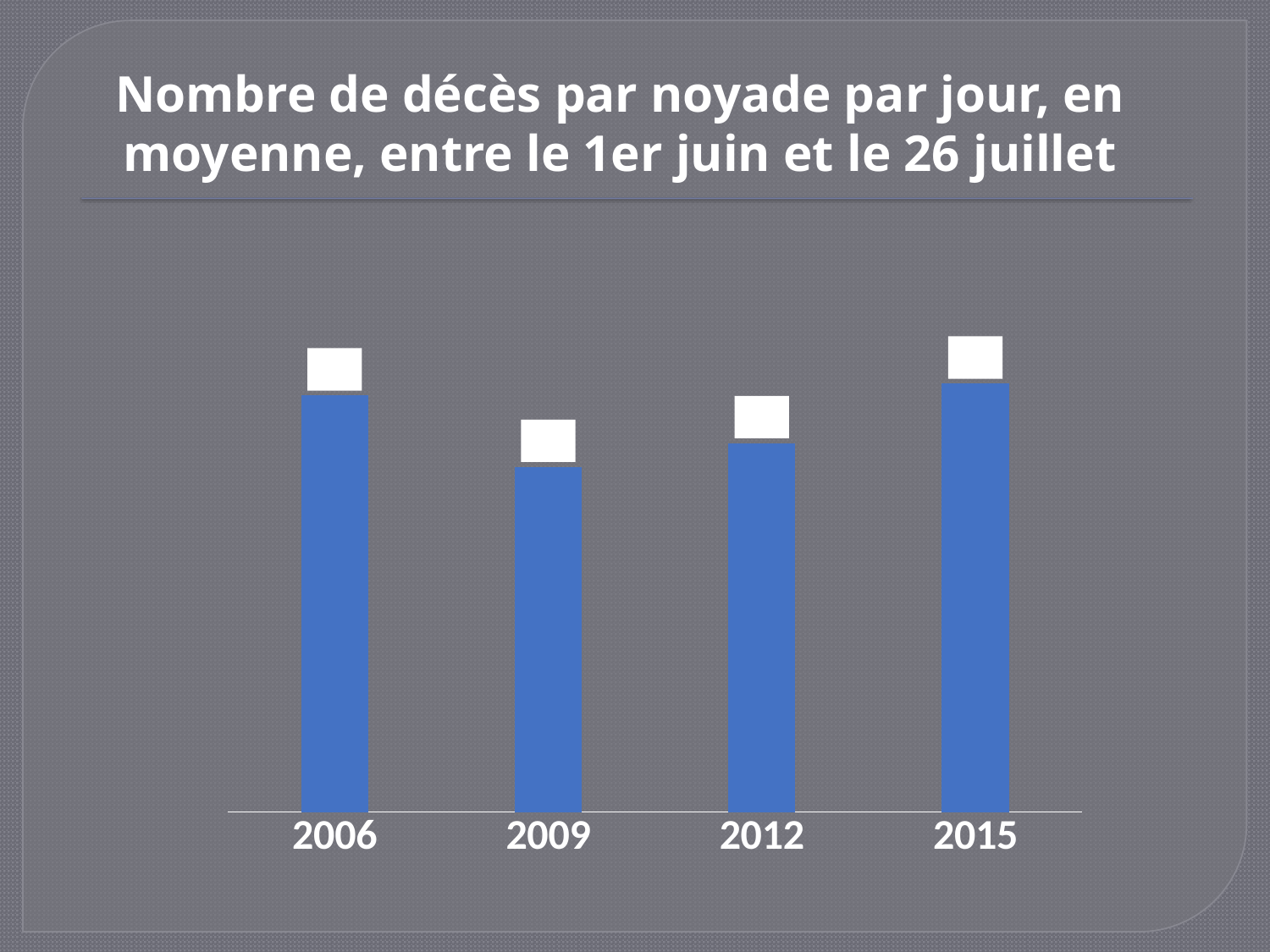
How many years are shown on the x axis of the chart? 4 Does the value rise or fall from 2006 to 2009? fall Which year is shown first on the x axis of the chart? 2006 Which year has the higher bar, 2006 or 2012? 2006 Does the value rise or fall from 2009 to 2015? rise What is the title of the chart on the slide? Nombre de décès par noyade par jour, en moyenne, entre le 1er juin et le 26 juillet Which year has the higher bar, 2006 or 2015? 2015 Which year has the lowest bar in the chart? 2009 What colour are the bars in the chart? blue Which year has the higher bar, 2009 or 2012? 2012 Which year has the highest bar in the chart? 2015 What kind of chart is shown on the slide? bar chart